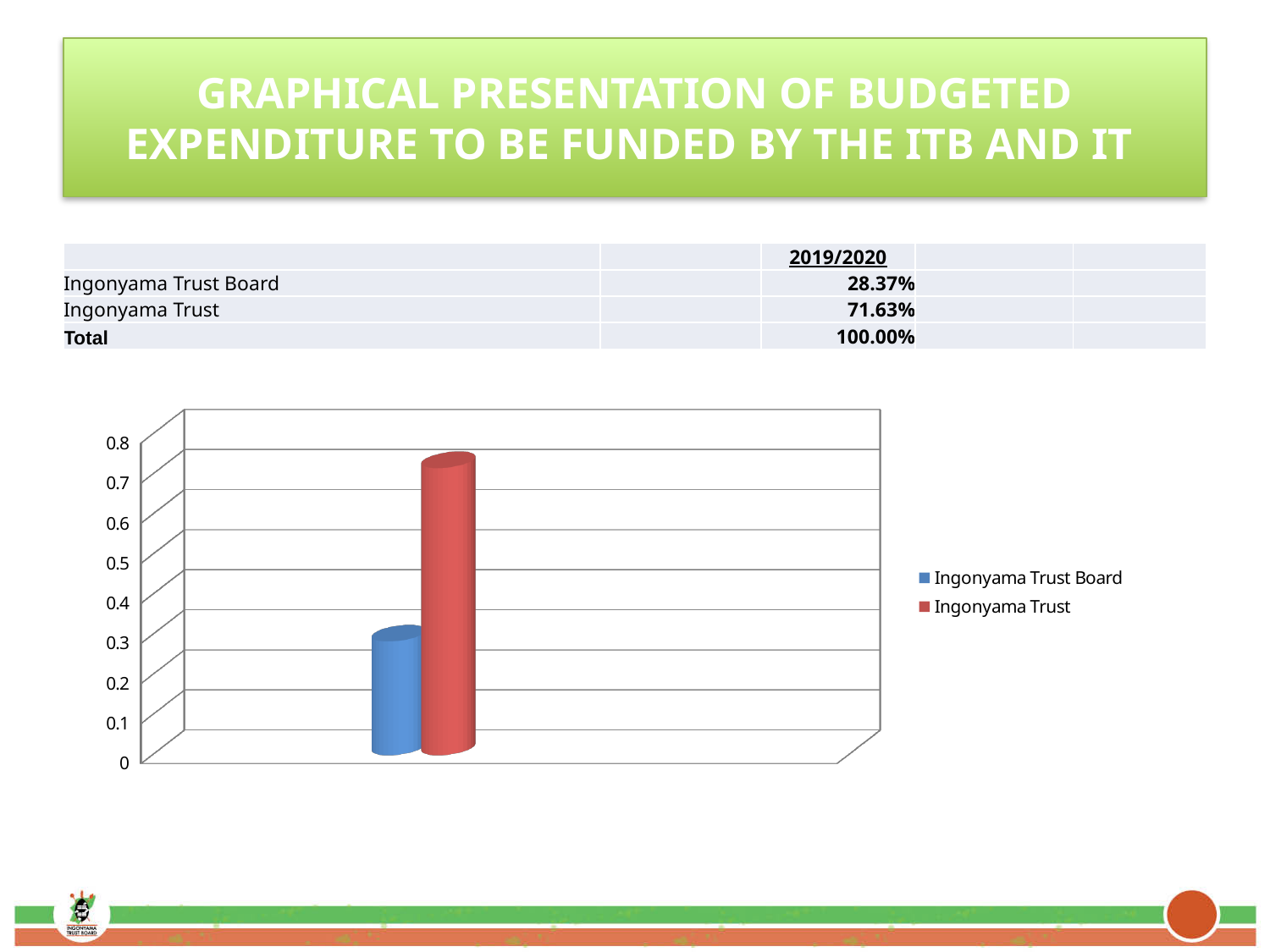
What colour is the bar for Ingonyama Trust in the chart? red According to the table on the slide, what share of the 2019/2020 budgeted expenditure is funded by the Ingonyama Trust? 71.63% Is the value for Ingonyama Trust Board greater or less than 0.4 on the chart's axis? less Which series has the shorter bar in the chart? Ingonyama Trust Board Which series has the taller bar in the chart? Ingonyama Trust Is the bar for Ingonyama Trust taller or shorter than the bar for Ingonyama Trust Board? taller Is the value for Ingonyama Trust greater or less than 0.6 on the chart's axis? greater What kind of chart is shown on the slide? bar chart How many series does the chart legend list? 2 What is the difference between the Ingonyama Trust share and the Ingonyama Trust Board share shown in the table? 43.26% According to the table on the slide, what share of the 2019/2020 budgeted expenditure is funded by the Ingonyama Trust Board? 28.37% What is the total shown in the table for 2019/2020? 100.00%